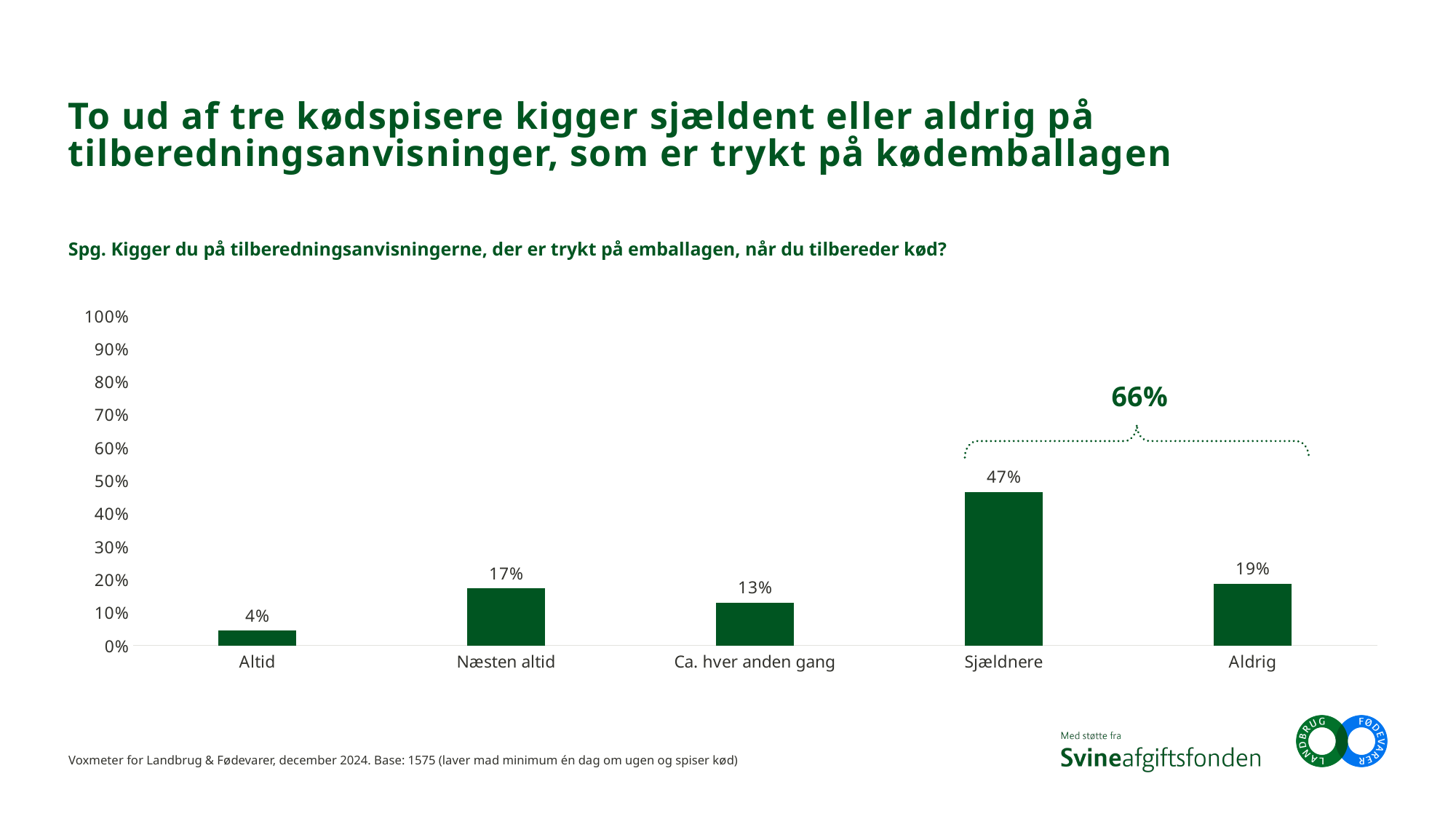
What is the value for "Altid"? 4% Which is larger, the value for "Næsten altid" or the value for "Ca. hver anden gang"? Næsten altid Which category has the lowest value? Altid What combined percentage is shown by the bracket above the "Sjældnere" and "Aldrig" bars? 66% What kind of chart is shown on the slide? Bar chart Which category has the highest value? Sjældnere What is the value for "Sjældnere"? 47% What is the value for "Aldrig"? 19% How many categories are shown on the x axis? 5 What is the value for "Næsten altid"? 17% What is the value for "Ca. hver anden gang"? 13% What is the difference between the values for "Sjældnere" and "Aldrig"? 28%